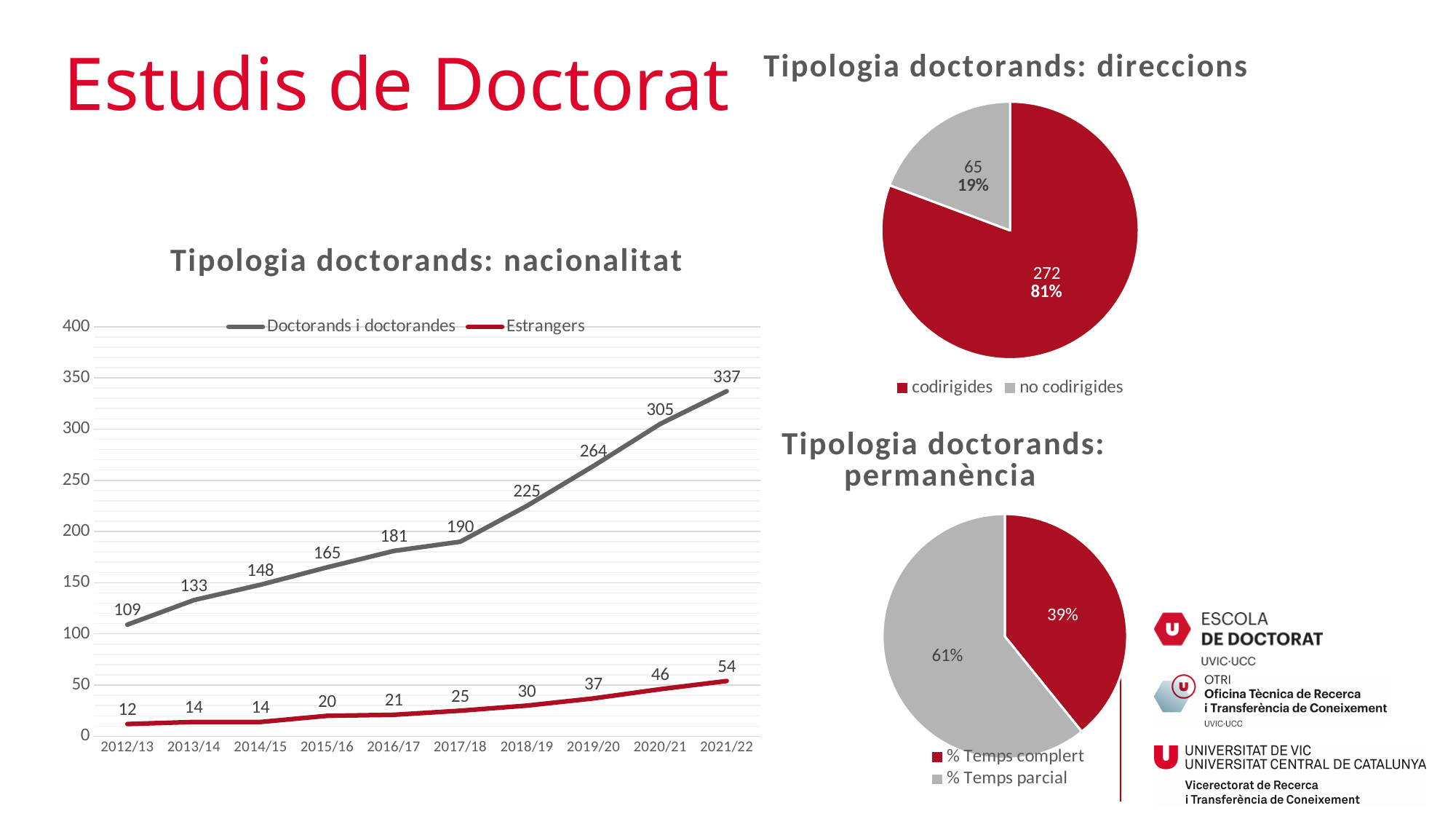
What kind of chart is 'Tipologia doctorands: nacionalitat'? line chart In the 'Tipologia doctorands: nacionalitat' chart, which year has the lowest value for 'Doctorands i doctorandes'? 2012/13 In the 'Tipologia doctorands: permanència' pie chart, which slice is larger, '% Temps complert' or '% Temps parcial'? % Temps parcial In the 'Tipologia doctorands: nacionalitat' chart, what is the value for 'Estrangers' in 2017/18? 25 In the 'Tipologia doctorands: nacionalitat' chart, do the values for 'Doctorands i doctorandes' rise or fall from 2012/13 to 2021/22? rise In the 'Tipologia doctorands: direccions' pie chart, what is the value for 'codirigides'? 272 In the 'Tipologia doctorands: nacionalitat' chart, what is the value for 'Doctorands i doctorandes' in 2021/22? 337 In the 'Tipologia doctorands: nacionalitat' chart, how many academic years are shown on the x axis? 10 In the 'Tipologia doctorands: nacionalitat' chart, what is the difference between 'Doctorands i doctorandes' and 'Estrangers' in 2021/22? 283 In the 'Tipologia doctorands: direccions' pie chart, what share of the pie is 'no codirigides'? 19% In the 'Tipologia doctorands: permanència' pie chart, what share is '% Temps complert'? 39% In the 'Tipologia doctorands: nacionalitat' chart, how many series does the legend list? 2